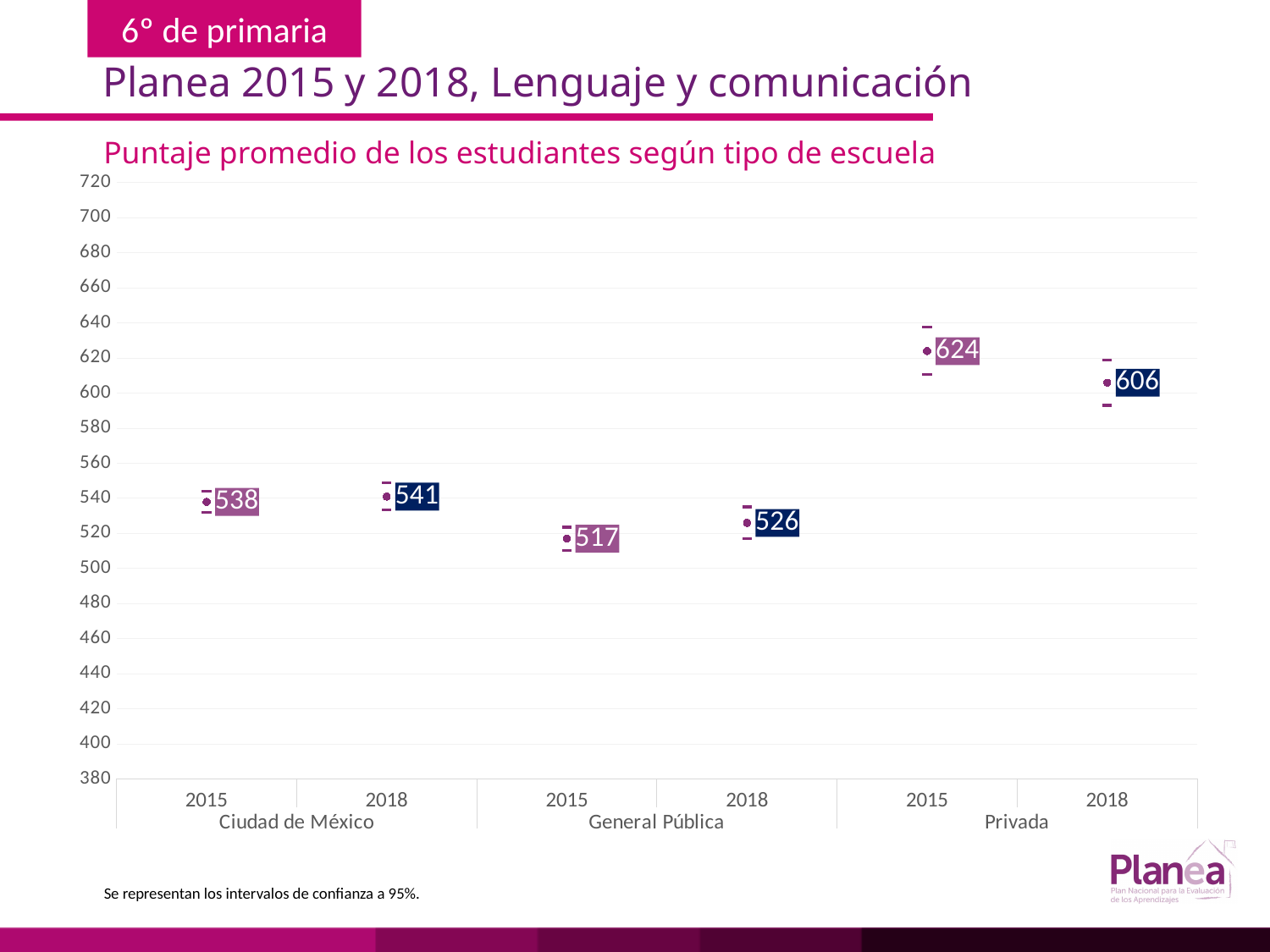
Did the Privada score rise or fall from 2015 to 2018? fall Which school type and year has the highest average score? Privada, 2015 What is the average score for General Pública in 2015? 517 Is the Privada 2015 score greater or less than 600? greater Which is larger, the Ciudad de México score in 2018 or the General Pública score in 2018? Ciudad de México 2018 What is the title of the chart? Puntaje promedio de los estudiantes según tipo de escuela What is the difference between the Privada scores in 2015 and 2018? 18 What is the average score for Ciudad de México in 2015? 538 What is the average score for Privada schools in 2018? 606 By how much did the General Pública score change from 2015 to 2018? 9 How many data points are plotted on the chart? 6 Which school type and year has the lowest average score? General Pública, 2015